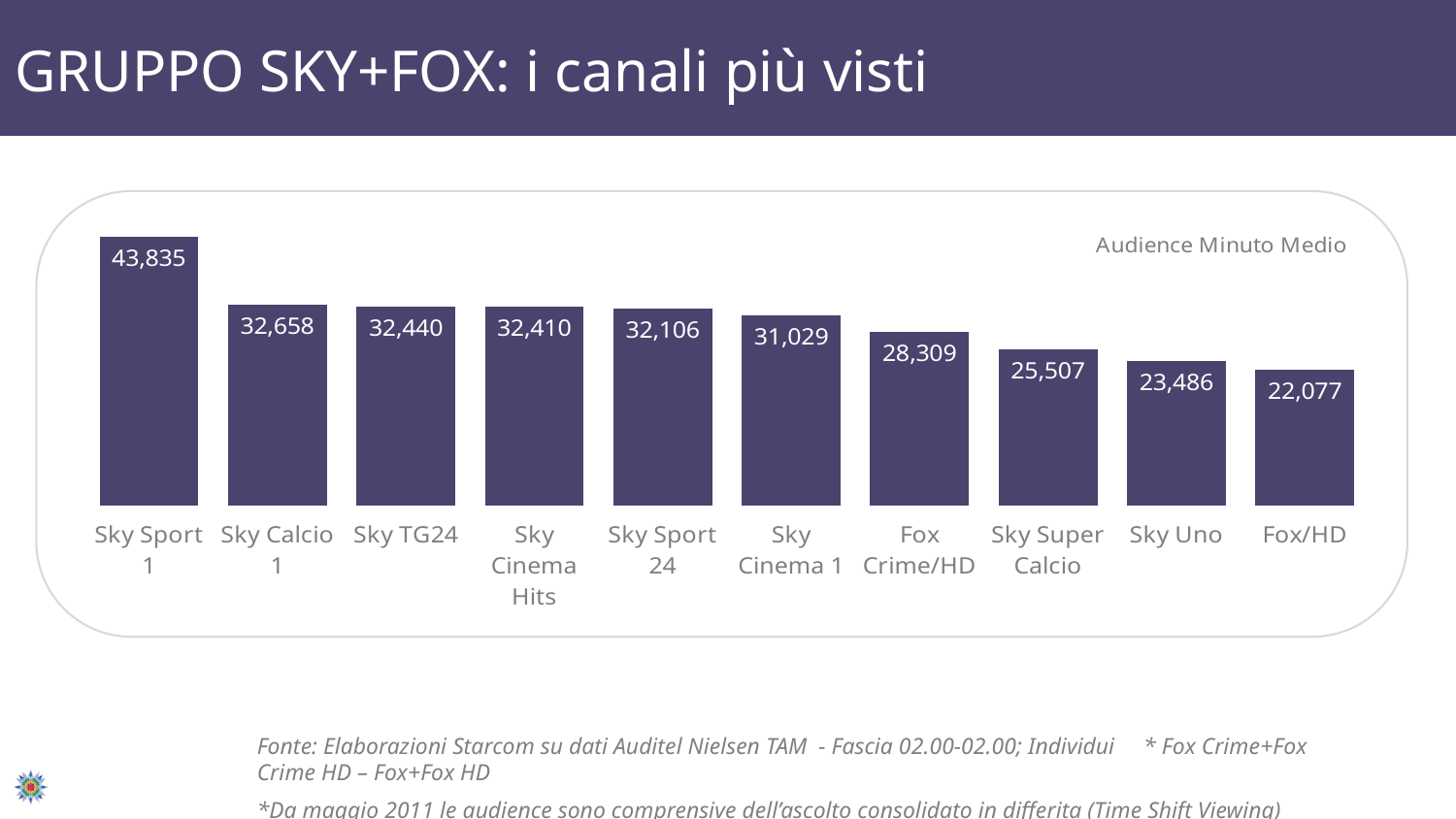
Do the values rise or fall from left to right across the chart? Fall What kind of chart is shown on the slide? Bar chart What is the difference between the values for Sky Sport 1 and Fox/HD? 21,758 What is the Audience Minuto Medio value for Sky Sport 1? 43,835 How many channels are shown in the chart? 10 Which channel has the lowest audience value in the chart? Fox/HD What is the value shown for Sky Uno? 23,486 What is the value shown for Fox Crime/HD? 28,309 What metric label is shown in the top right corner of the chart? Audience Minuto Medio Which channel has the highest audience value in the chart? Sky Sport 1 What is the difference between the values for Fox Crime/HD and Sky Uno? 4,823 Which has a larger value, Sky Sport 1 or Sky Super Calcio? Sky Sport 1